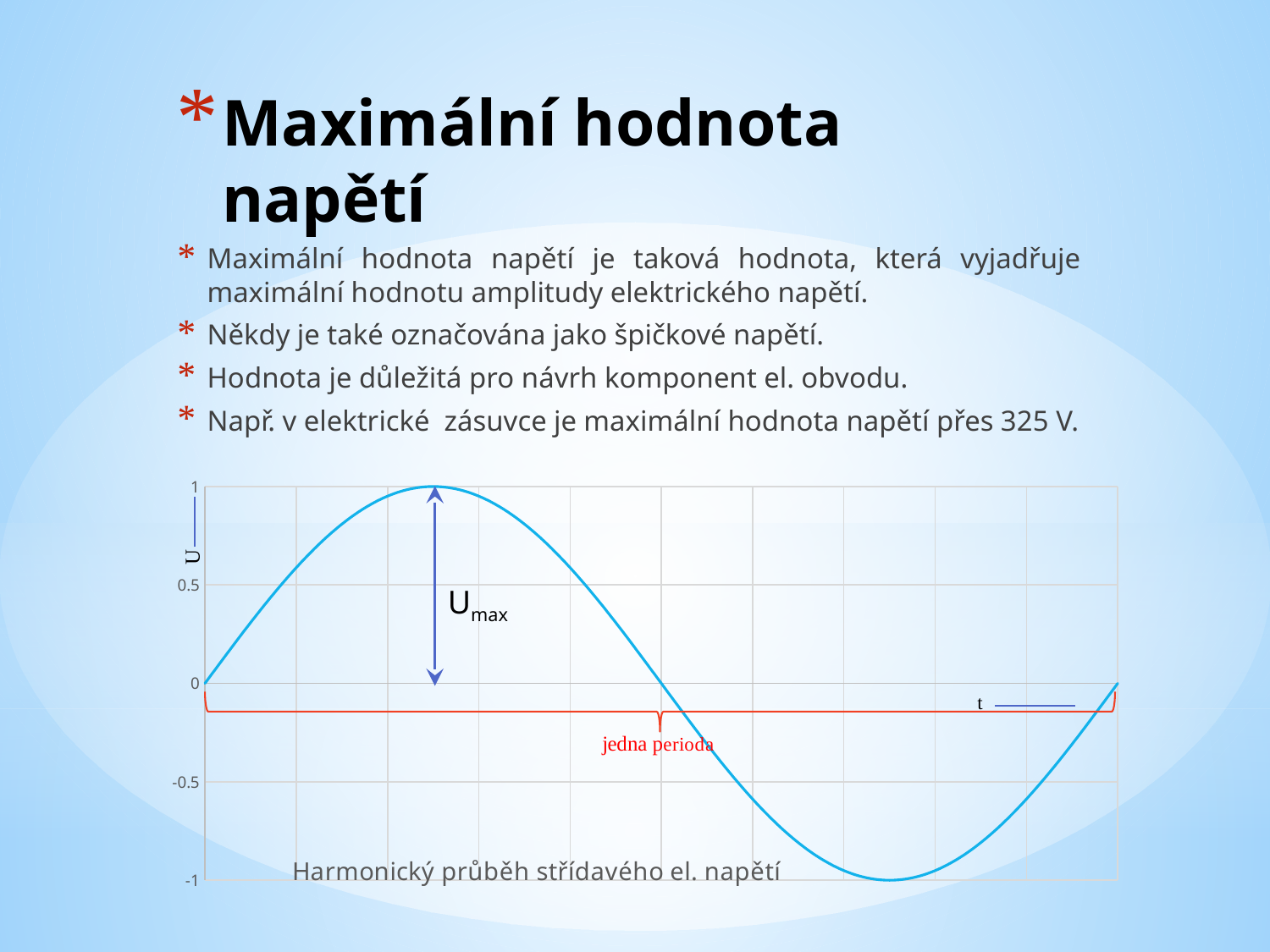
What is the value of the curve at the start of the horizontal axis? 0 What label is written next to the vertical axis of the chart? U What is the lowest value the curve reaches on the vertical axis? -1 What is the difference between the highest and lowest values the curve reaches? 2 Is the value of the curve at its trough greater or less than -0.5? less What is the highest value the curve reaches on the vertical axis? 1 What is the title printed on the chart? Harmonický průběh střídavého el. napětí Does the curve rise or fall between its peak and its trough? fall What kind of chart is shown on the slide? line chart Is the value of the curve at its peak greater or less than 0.5? greater Does the curve rise or fall over the first quarter of the horizontal axis? rise Which is larger, the value of the curve at its peak or the value at the start of the horizontal axis? the peak